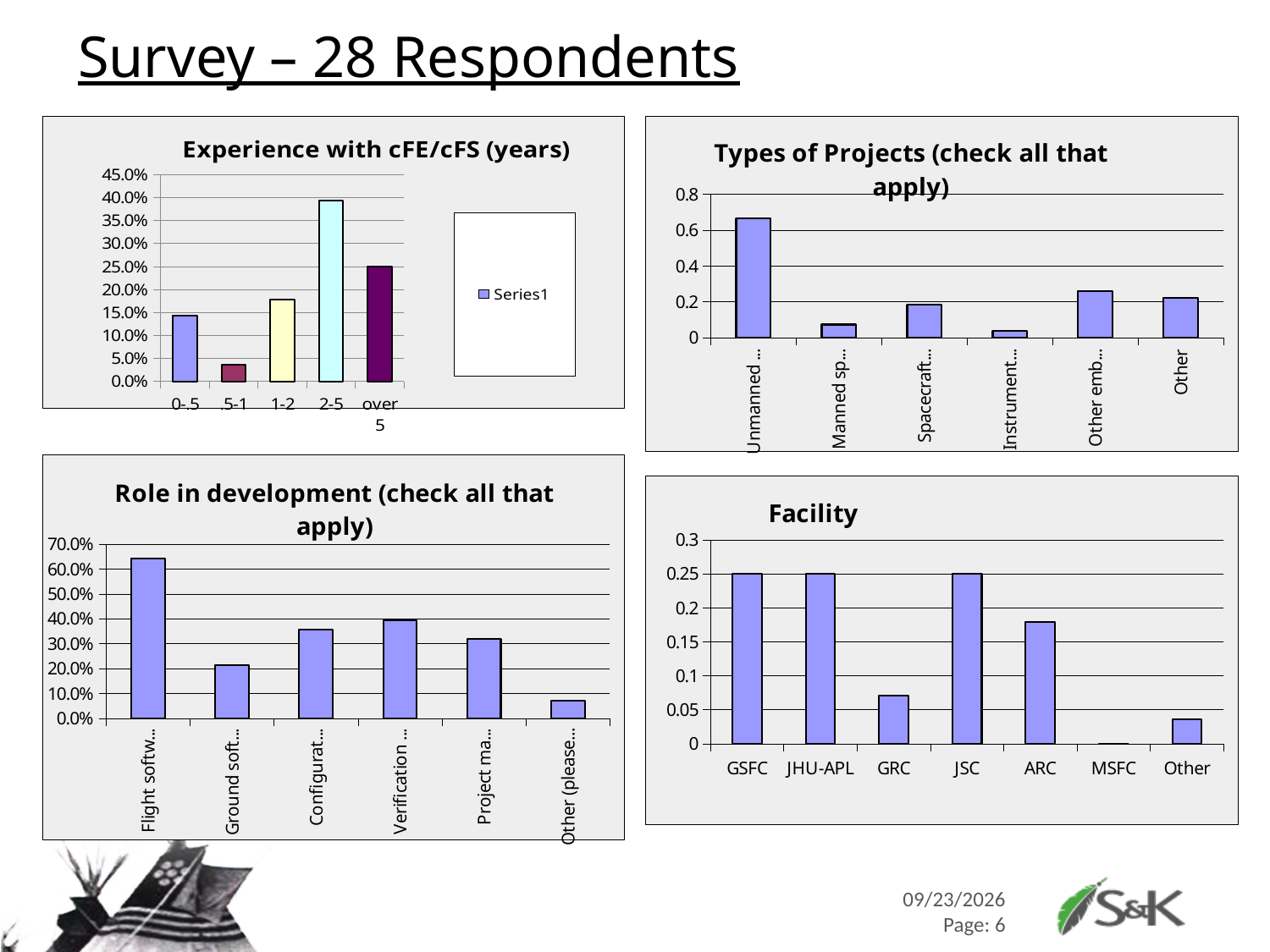
In the 'Experience with cFE/cFS (years)' chart, is the value for 2-5 greater or less than 35.0%? greater How many series does the legend of the 'Experience with cFE/cFS (years)' chart list? 1 What kind of chart is the 'Facility' chart? Bar chart In the 'Role in development (check all that apply)' chart, which category has the highest value? Flight software In the 'Types of Projects (check all that apply)' chart, which category has the highest value? Unmanned In the 'Facility' chart, what is the value for GSFC? 0.25 In the 'Experience with cFE/cFS (years)' chart, which category has the lowest value? .5-1 In the 'Facility' chart, which facility has the lowest value? MSFC In the 'Role in development (check all that apply)' chart, is the value for Flight software greater or less than 60.0%? greater In the 'Experience with cFE/cFS (years)' chart, which category has the highest value? 2-5 How many categories are shown in the 'Role in development (check all that apply)' chart? 6 In the 'Types of Projects (check all that apply)' chart, is the value for Unmanned greater or less than 0.6? greater